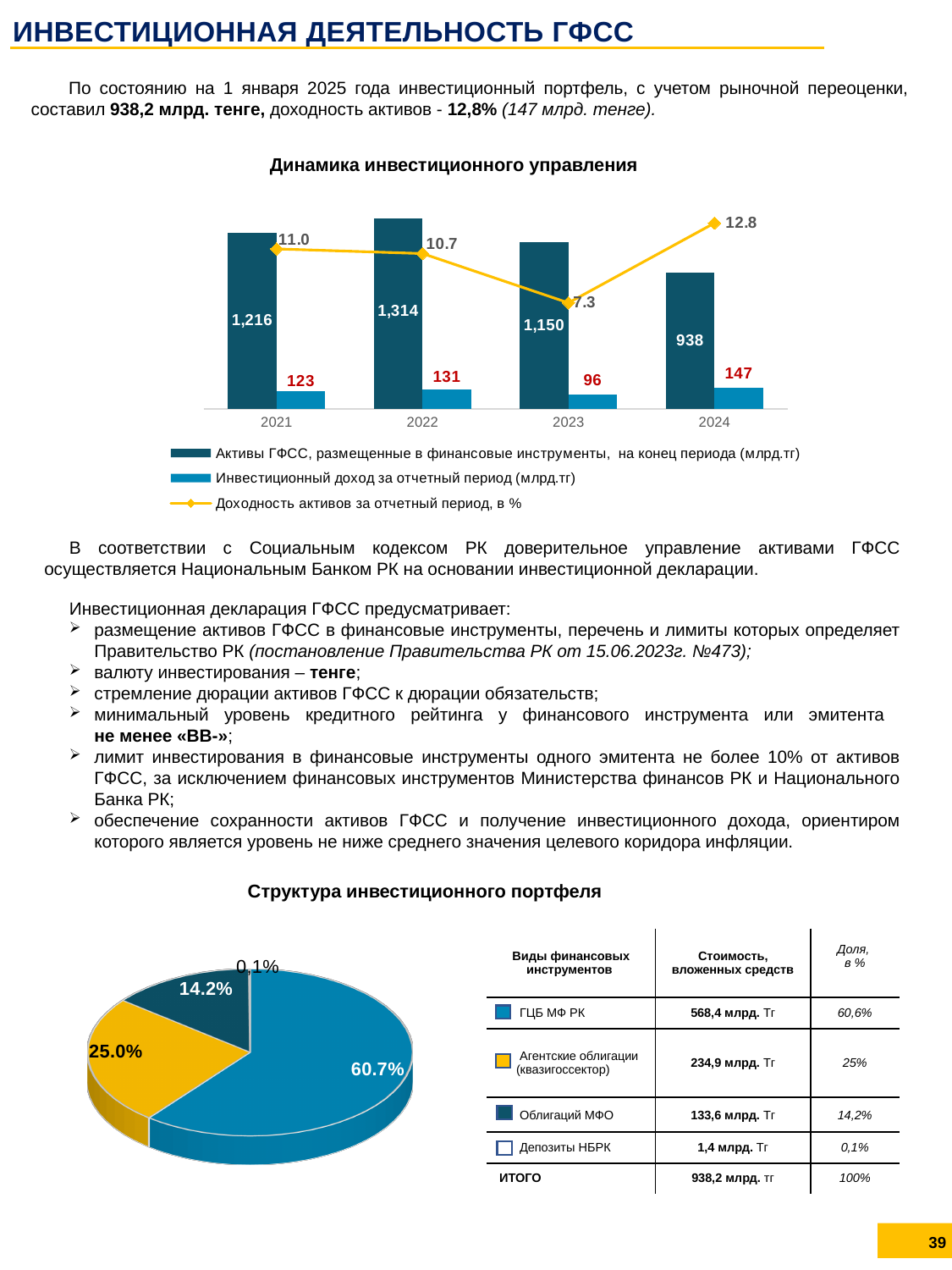
In the chart 'Динамика инвестиционного управления', what is the asset yield (доходность активов) for 2024? 12.8 In the chart 'Динамика инвестиционного управления', by how much does the investment income for 2024 exceed that for 2023? 51 How many years are shown on the x axis of the chart 'Динамика инвестиционного управления'? 4 In the chart 'Динамика инвестиционного управления', which year has the highest value of assets placed in financial instruments? 2022 In the chart 'Динамика инвестиционного управления', which year has the higher asset yield: 2021 or 2022? 2021 In the chart 'Динамика инвестиционного управления', what is the investment income for 2023? 96 What kind of chart is used for 'Структура инвестиционного портфеля'? pie chart In the chart 'Динамика инвестиционного управления', do the assets placed in financial instruments rise or fall from 2022 to 2024? fall How many series does the legend of the chart 'Динамика инвестиционного управления' list? 3 In the pie chart 'Структура инвестиционного портфеля', what is the share of the largest slice? 60.7% In the chart 'Динамика инвестиционного управления', what is the value of ГФСС assets placed in financial instruments for 2022? 1,314 In the chart 'Динамика инвестиционного управления', which year has the lowest investment income? 2023